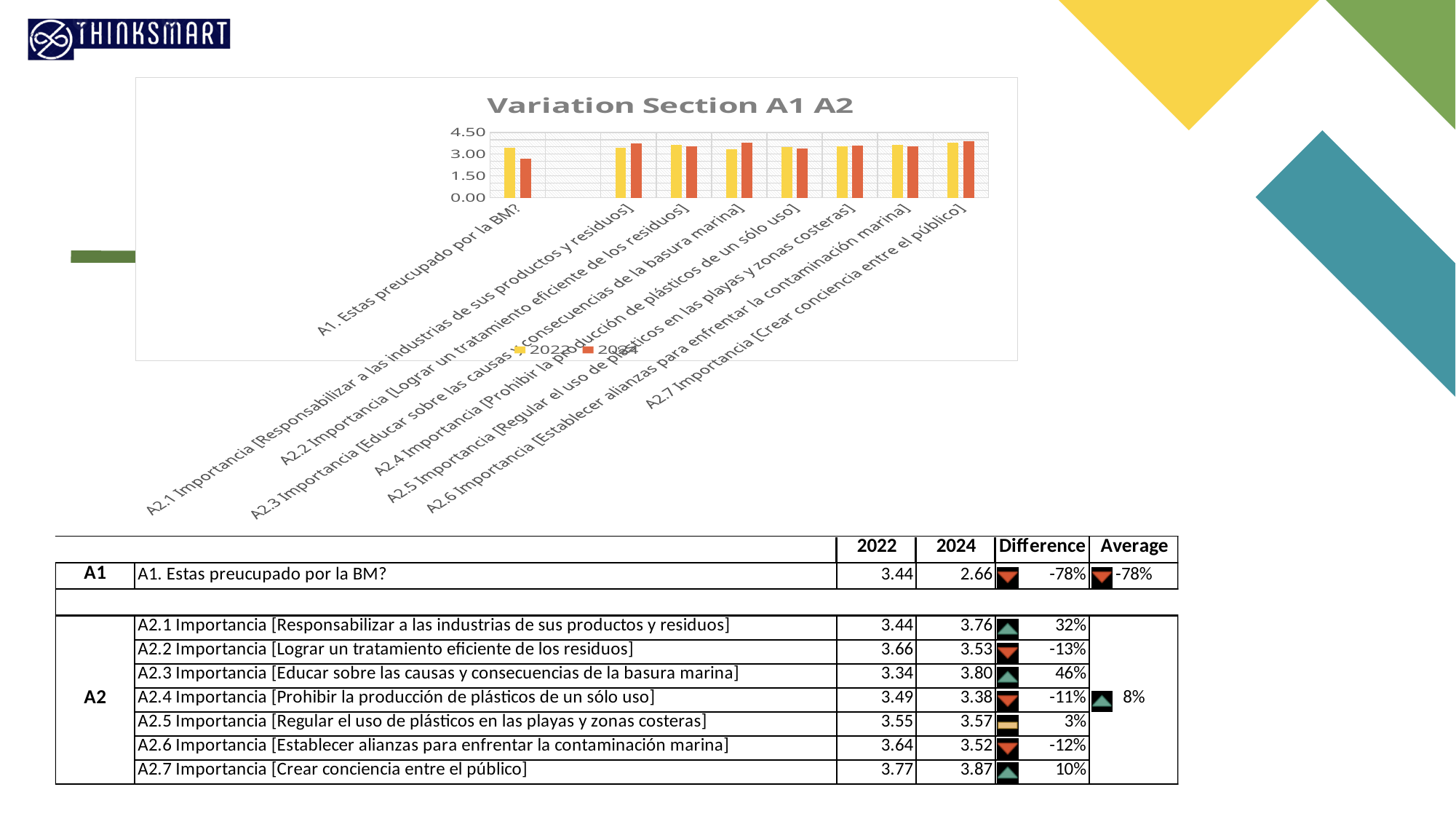
What kind of chart is shown on the slide? bar chart For 'A1. Estas preucupado por la BM?', which is larger, the 2022 value or the 2024 value? 2022 Is the 2024 value for 'A2.7 Importancia [Crear conciencia entre el público]' greater or less than 3.00? greater Which category has the lowest 2024 value? A1. Estas preucupado por la BM? How many series does the chart legend list? 2 Which series is shown in yellow in the chart? 2022 Is the 2024 value for 'A1. Estas preucupado por la BM?' greater or less than 3.00? less What is the 2022 value for 'A2.7 Importancia [Crear conciencia entre el público]'? 3.77 What is the title of the chart? Variation Section A1 A2 What is the difference between the 2022 and 2024 values for 'A1. Estas preucupado por la BM?'? 0.78 What is the 2024 value for 'A2.3 Importancia [Educar sobre las causas y consecuencias de la basura marina]'? 3.80 How many categories are plotted on the x axis of the chart? 8